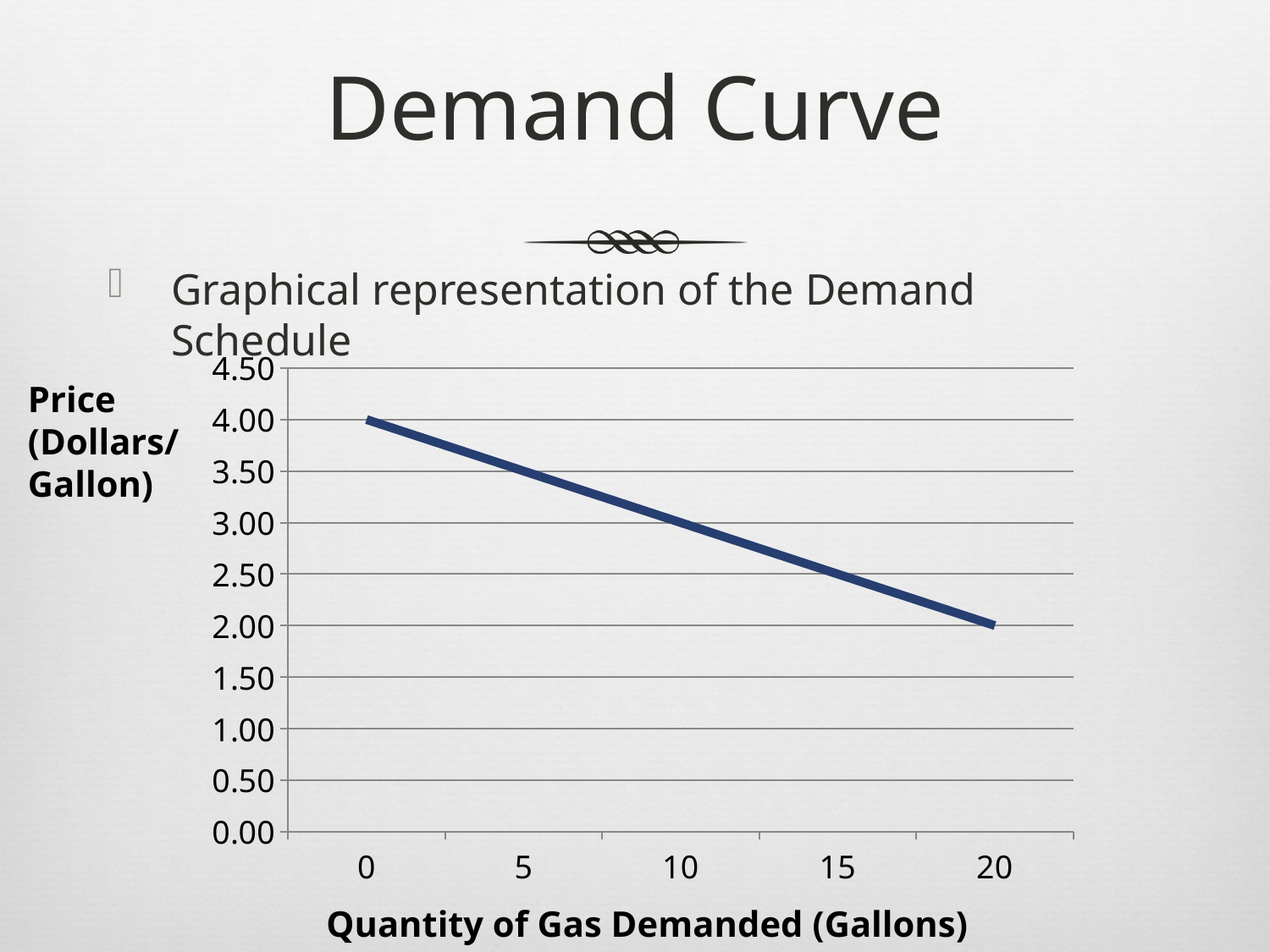
Which quantity has the higher price, 0 gallons or 20 gallons? 0 gallons What is the price when the quantity of gas demanded is 0 gallons? 4.00 At which quantity of gas demanded is the price lowest? 20 What is the label on the x axis of the chart? Quantity of Gas Demanded (Gallons) What kind of chart is shown on the slide? line chart What is the label on the y axis of the chart? Price (Dollars/Gallon) Is the price at a quantity of 5 gallons greater or less than 3.00? greater Does the price rise or fall as the quantity of gas demanded increases along the x axis? fall What is the price when the quantity of gas demanded is 20 gallons? 2.00 What is the price when the quantity of gas demanded is 10 gallons? 3.00 Is the price at a quantity of 15 gallons greater or less than 3.00? less At which quantity of gas demanded is the price highest? 0